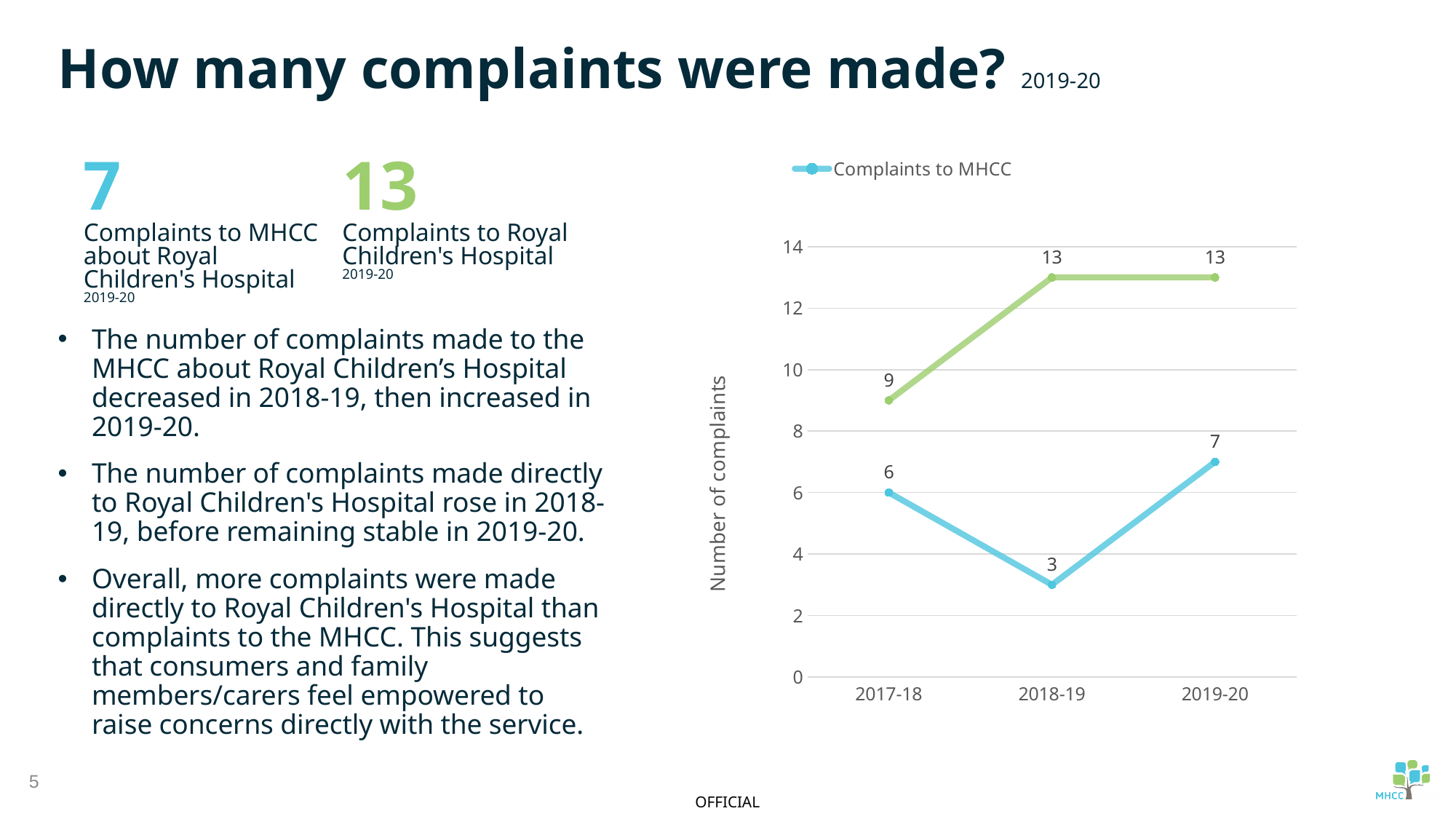
What is the value for Complaints to MHCC in 2019-20? 7 What is the value of the green line in 2017-18? 9 How many years are shown on the x axis? 3 In which year is the value for Complaints to MHCC highest? 2019-20 What is the value for Complaints to MHCC in 2018-19? 3 In which year is the value for Complaints to MHCC lowest? 2018-19 In 2017-18, which line has the higher value, the green line or the Complaints to MHCC line? The green line What is the difference between the green line and the Complaints to MHCC line in 2019-20? 6 What kind of chart is shown on the slide? Line chart How many series does the legend list? 1 Does the value for Complaints to MHCC rise or fall from 2017-18 to 2018-19? Fall By how much did Complaints to MHCC increase from 2018-19 to 2019-20? 4